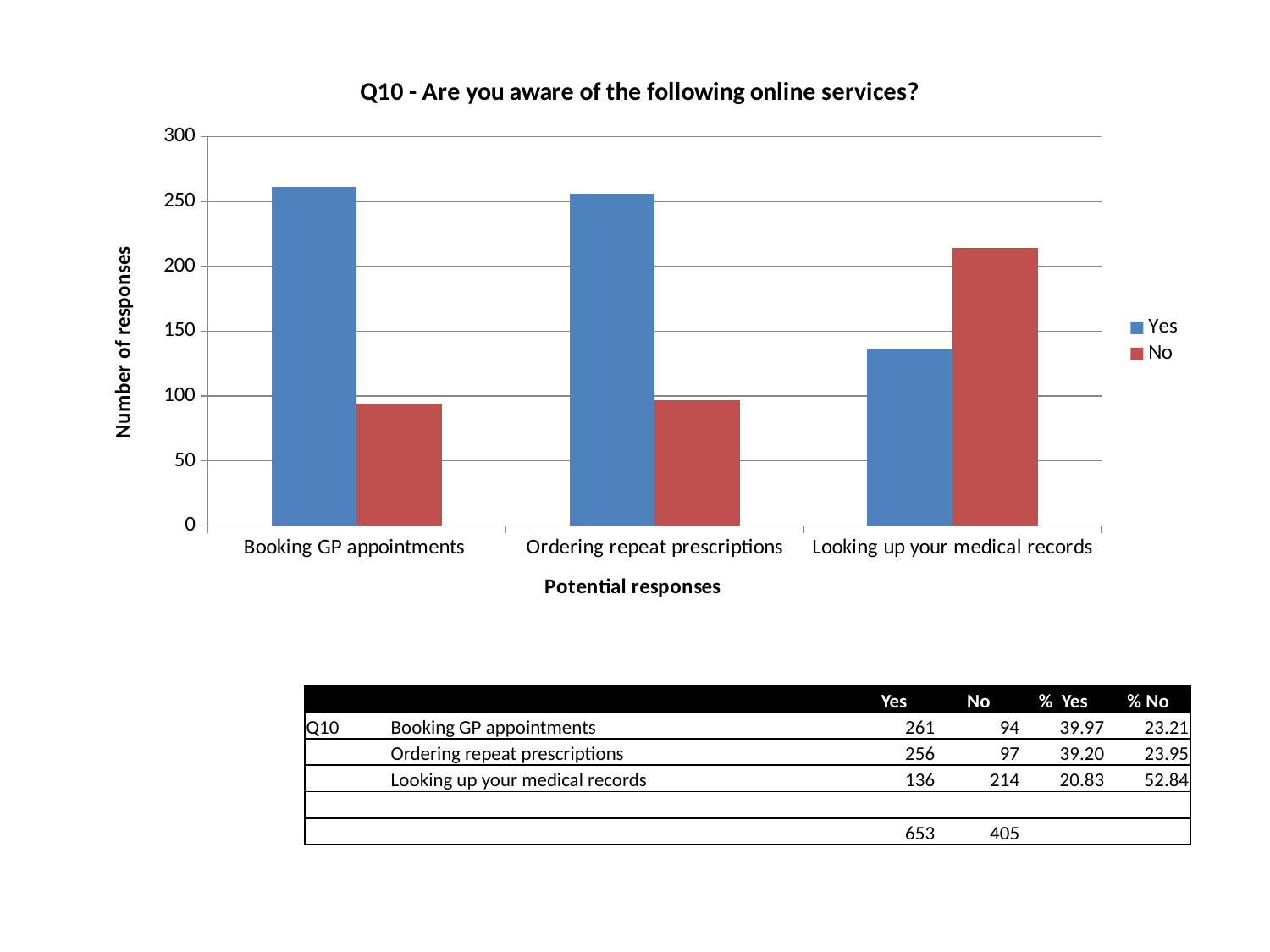
What kind of chart is shown on the slide? bar chart What is the number of Yes responses for Booking GP appointments? 261 How many series does the chart legend list? 2 What is the difference between Yes and No responses for Looking up your medical records? 78 Is the Yes value for Ordering repeat prescriptions greater or less than 200? greater What is the number of No responses for Ordering repeat prescriptions? 97 Which category has the highest number of Yes responses? Booking GP appointments Which category has the lowest number of No responses? Booking GP appointments For Looking up your medical records, which is larger: the Yes bar or the No bar? No How many categories are shown on the x axis of the chart? 3 What is the number of No responses for Looking up your medical records? 214 What is the title of the chart? Q10 - Are you aware of the following online services?